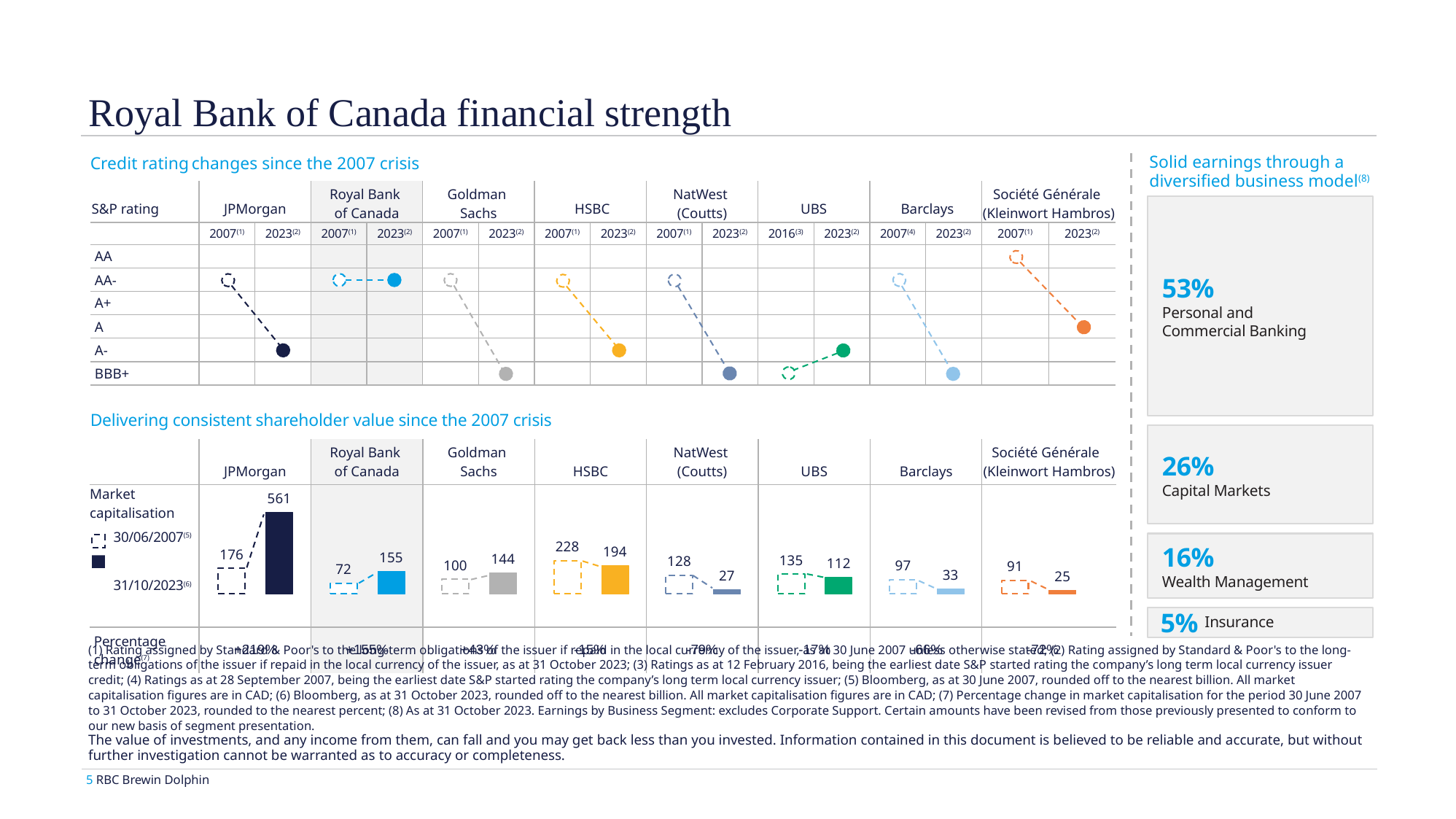
In the market capitalisation chart, was HSBC's market capitalisation larger on 30/06/2007 or on 31/10/2023? 30/06/2007 How many series does the legend of the market capitalisation chart list? 2 In the 'Credit rating changes since the 2007 crisis' chart, what is Royal Bank of Canada's S&P rating in 2023? AA- What kind of chart is used for the 'Delivering consistent shareholder value since the 2007 crisis' section? Bar chart In the 'Delivering consistent shareholder value since the 2007 crisis' chart, what is JPMorgan's market capitalisation as at 31/10/2023? 561 In the market capitalisation chart, which bank has the highest market capitalisation as at 31/10/2023? JPMorgan In the market capitalisation chart, what is NatWest (Coutts)'s market capitalisation as at 31/10/2023? 27 In the 'Credit rating changes since the 2007 crisis' chart, what was Société Générale's S&P rating in 2007? AA In the market capitalisation chart, which bank has the lowest market capitalisation as at 31/10/2023? Société Générale (Kleinwort Hambros) In the market capitalisation chart, by how much did Royal Bank of Canada's market capitalisation increase from 30/06/2007 to 31/10/2023? 83 How many banks are shown in the market capitalisation chart? 8 In the market capitalisation chart, what was Royal Bank of Canada's market capitalisation as at 30/06/2007? 72